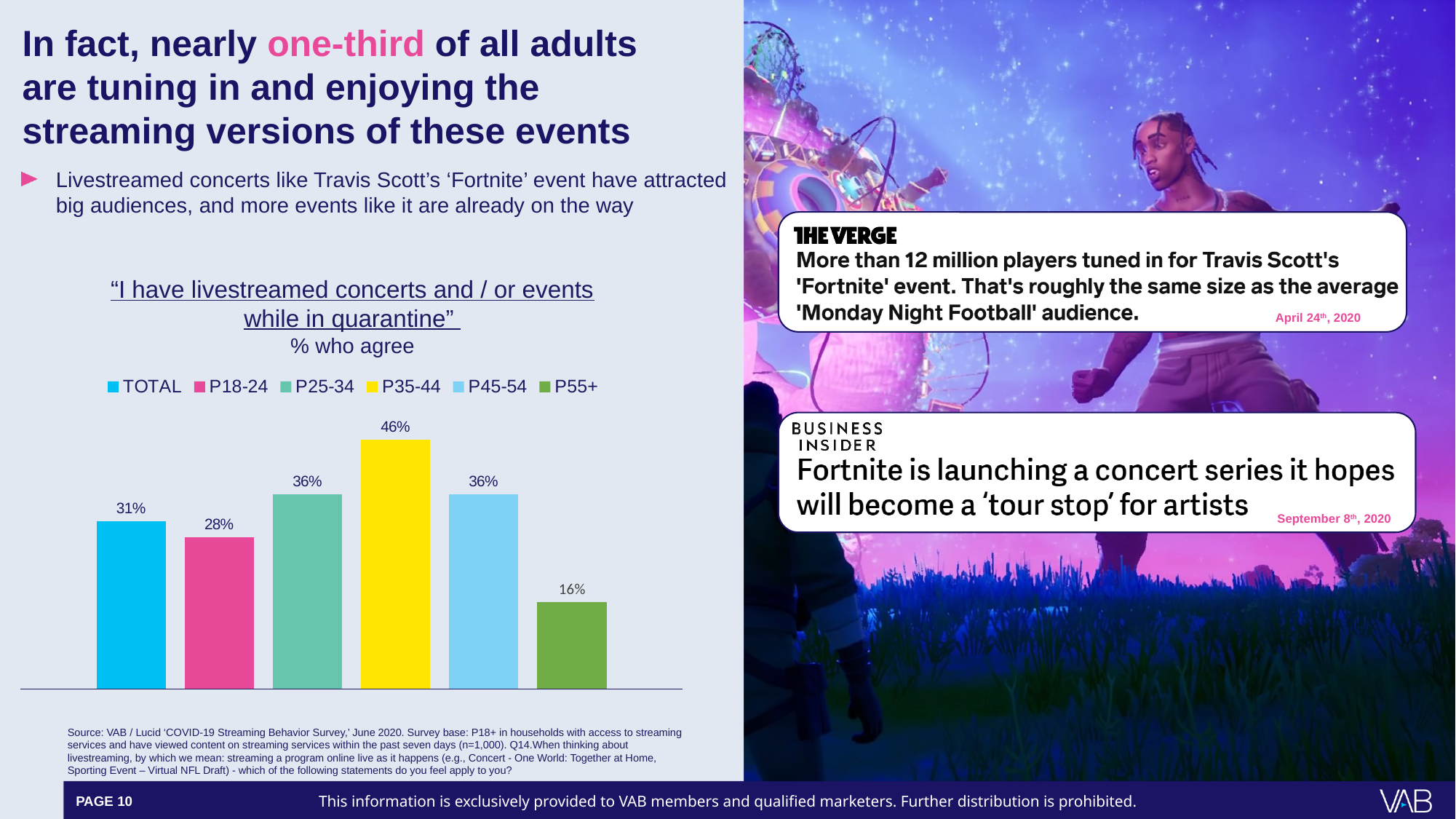
What kind of chart is shown on the slide? Bar chart Which group has the highest percentage who agree? P35-44 What colour is the bar for P35-44? Yellow How many entries does the chart legend list? 6 What percentage of the TOTAL group agree they have livestreamed concerts and/or events while in quarantine? 31% What is the difference between the TOTAL value and the P18-24 value? 3% What is the value for P55+ in the chart? 16% Which is larger, the value for P25-34 or the value for P18-24? P25-34 What is the difference between the P35-44 value and the P55+ value? 30% What is the value for P18-24 in the chart? 28% How many groups are shown in the chart? 6 Which group has the lowest percentage who agree? P55+